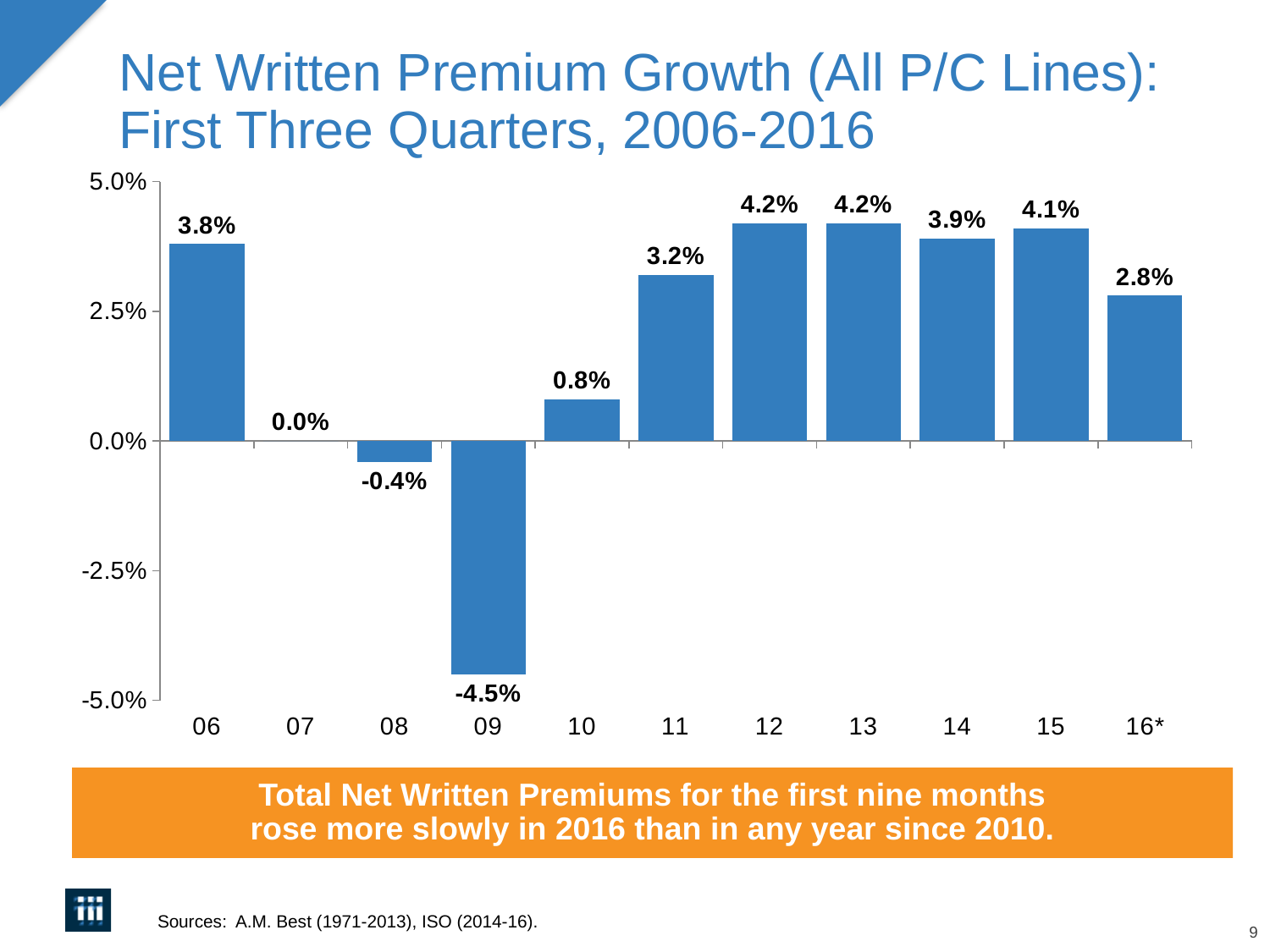
Do the values rise or fall from 2009 to 2012? rise How many years are shown on the x axis? 11 Which year has the lowest net written premium growth? 09 What is the net written premium growth value for 2009? -4.5% What is the title of the chart? Net Written Premium Growth (All P/C Lines): First Three Quarters, 2006-2016 What is the net written premium growth value for 16*? 2.8% Which is larger, the value for 2014 or the value for 2015? 2015 What kind of chart is shown on the slide? bar chart What is the value shown for 2011? 3.2% What is the difference between the values for 2006 and 2010? 3.0% What is the difference between the values for 2015 and 2016*? 1.3% Is the value for 2011 greater or less than 2.5%? greater